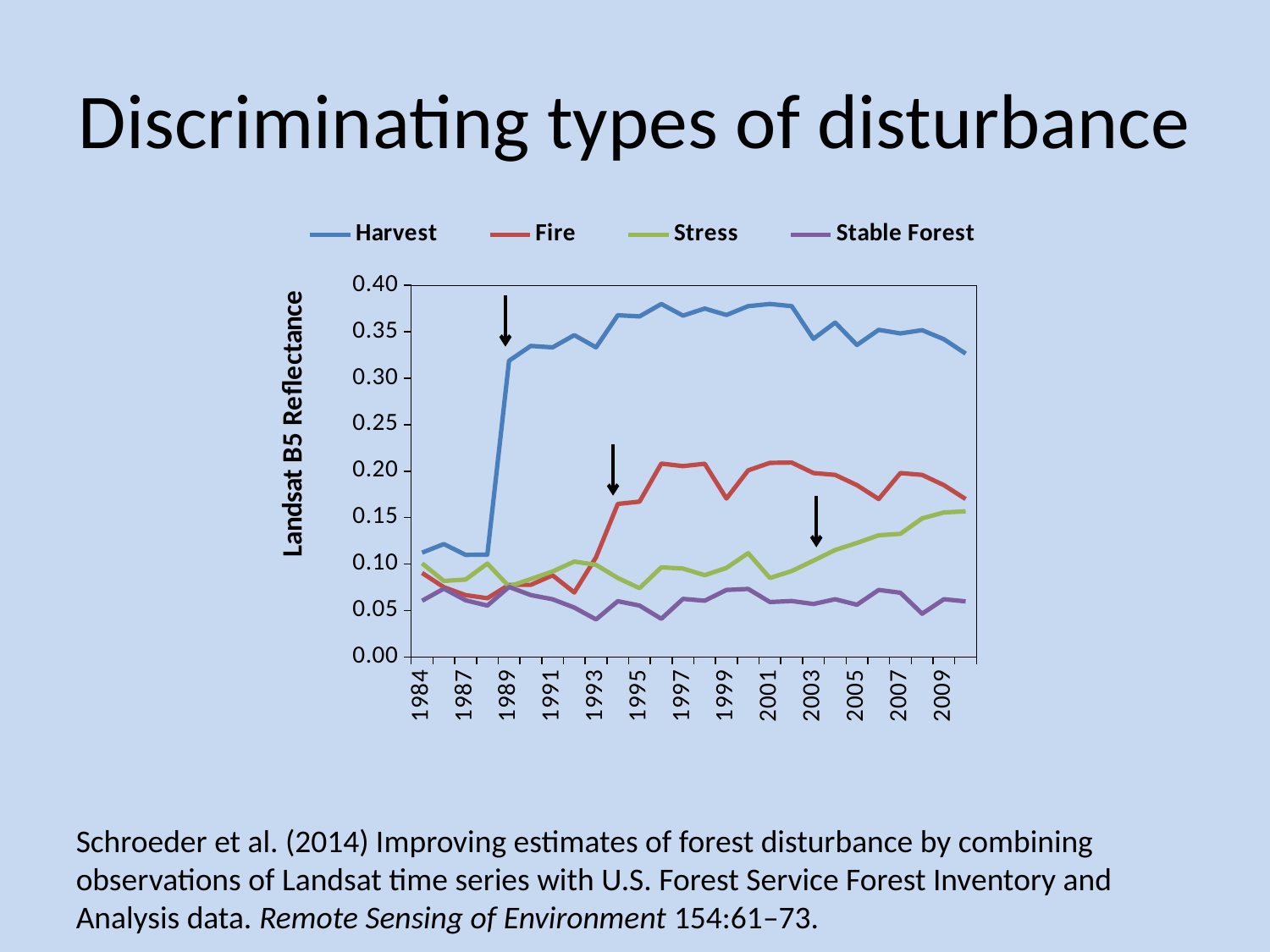
Is the Stress value in 2003 greater or less than 0.15? less Which series stays lowest across the whole time period? Stable Forest Is the Stable Forest value in 2009 greater or less than 0.10? less Is the Harvest value in 1984 greater or less than 0.15? less How many series does the legend list? 4 Does the Stress series rise or fall between 2003 and 2010? rise What kind of chart is shown on the slide? line chart Which series reaches the highest Landsat B5 Reflectance value on the chart? Harvest What is the label on the y axis of the chart? Landsat B5 Reflectance In 2000, which series has the larger value, Harvest or Fire? Harvest